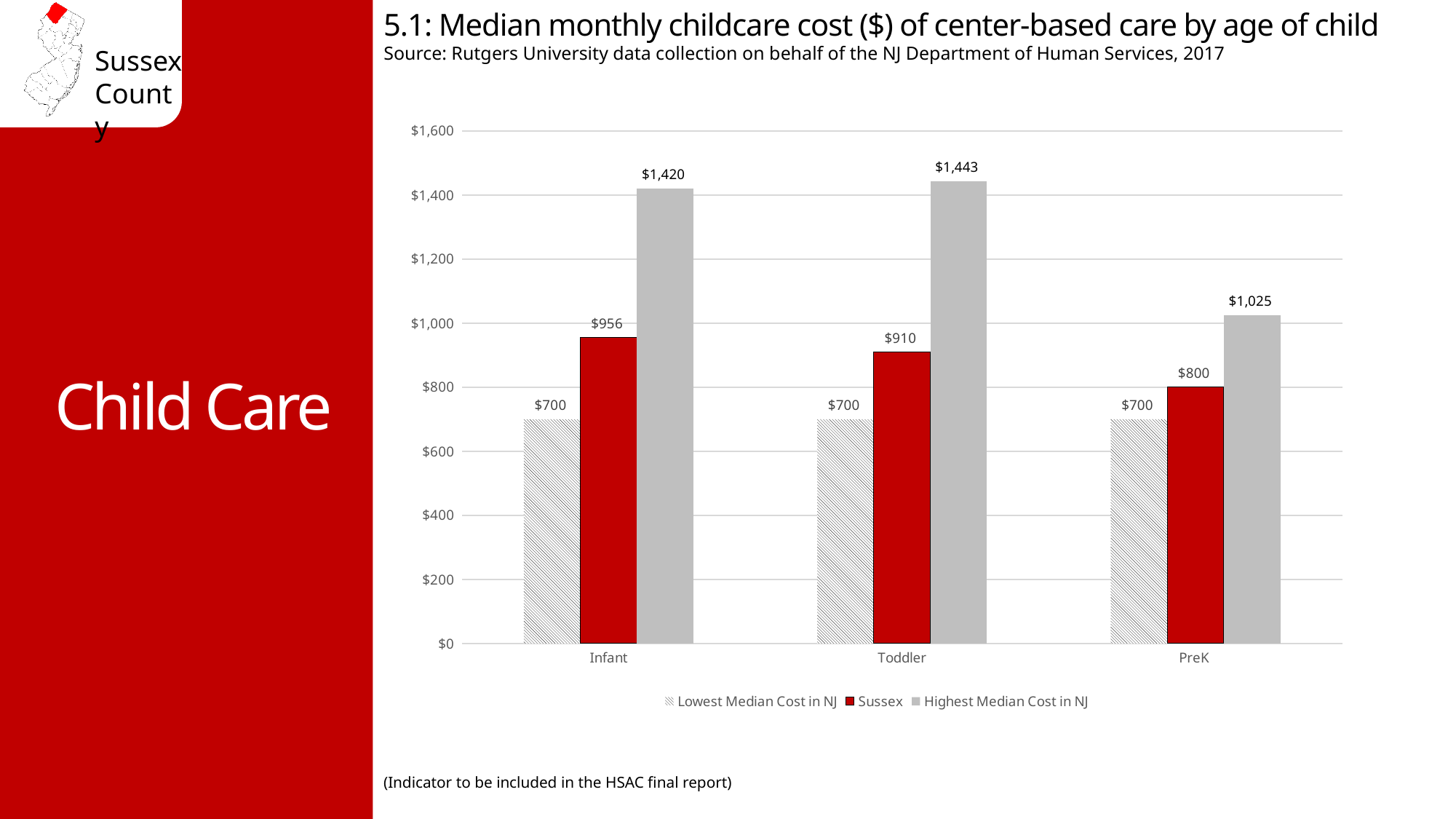
Is the Sussex cost for Toddler care larger or smaller than the Sussex cost for PreK care? larger Which age group has the lowest Highest Median Cost in NJ? PreK What kind of chart is shown on the slide? bar chart What is the difference between the Highest Median Cost in NJ and the Sussex cost for Infant care? $464 Which age group has the highest Sussex median monthly cost? Infant How many age groups are shown on the x axis? 3 Which series is shown in red? Sussex Is the Highest Median Cost in NJ for PreK care greater or less than $1,200? less What is the Highest Median Cost in NJ for Toddler care? $1,443 How many series does the legend list? 3 What is the Sussex median monthly childcare cost for Infant care? $956 What is the Lowest Median Cost in NJ for PreK care? $700